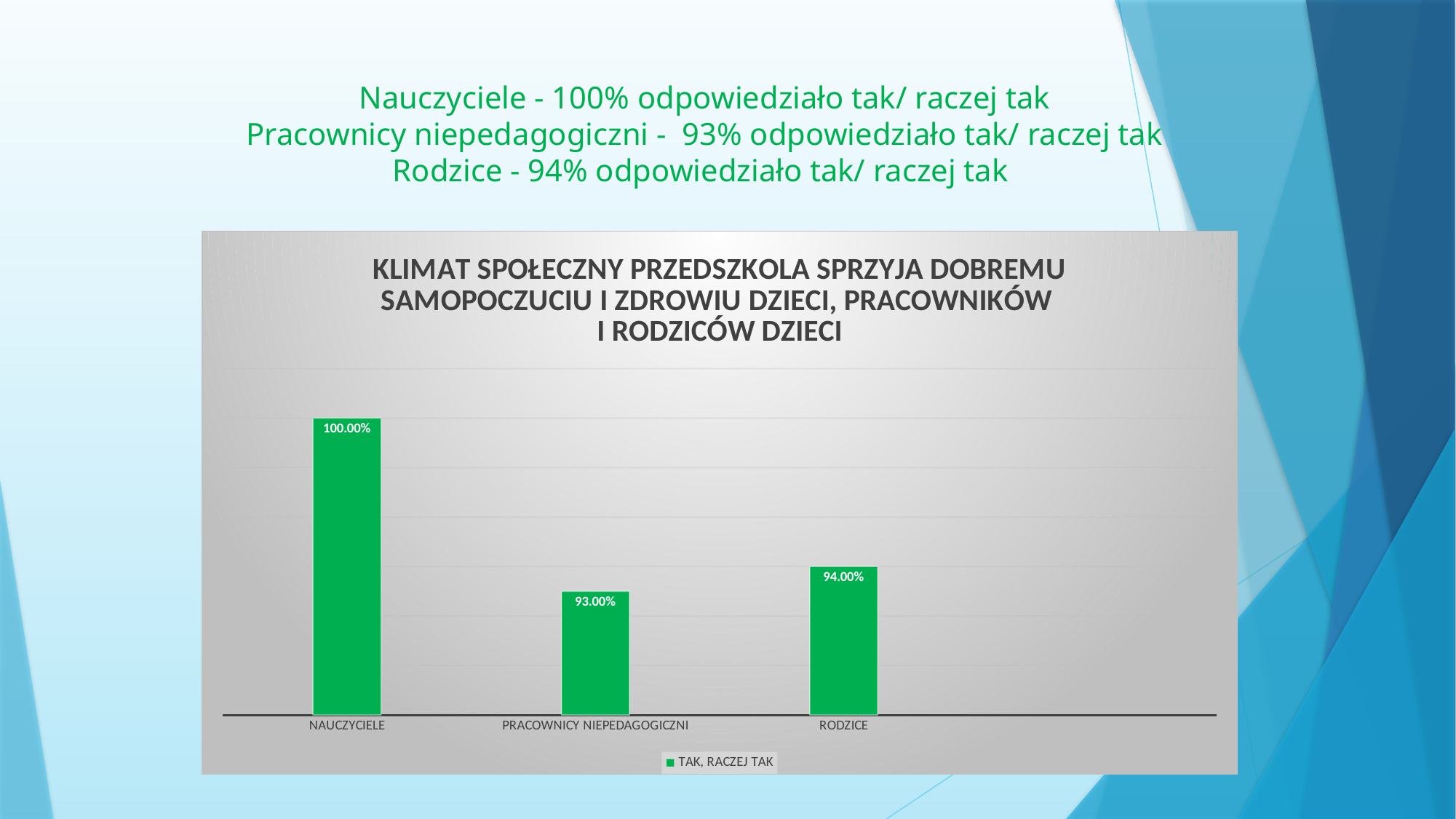
What is the difference between the values for NAUCZYCIELE and PRACOWNICY NIEPEDAGOGICZNI? 7.00% What is the value for NAUCZYCIELE? 100.00% Which category has the lowest value? PRACOWNICY NIEPEDAGOGICZNI What is the difference between the values for RODZICE and PRACOWNICY NIEPEDAGOGICZNI? 1.00% What kind of chart is shown? bar chart Which category has the highest value? NAUCZYCIELE How many categories are shown on the x axis? 3 What is the value for RODZICE? 94.00% How many series does the legend list? 1 Which is larger, the value for NAUCZYCIELE or the value for RODZICE? NAUCZYCIELE What is the value for PRACOWNICY NIEPEDAGOGICZNI? 93.00% What is the legend entry for the series? TAK, RACZEJ TAK